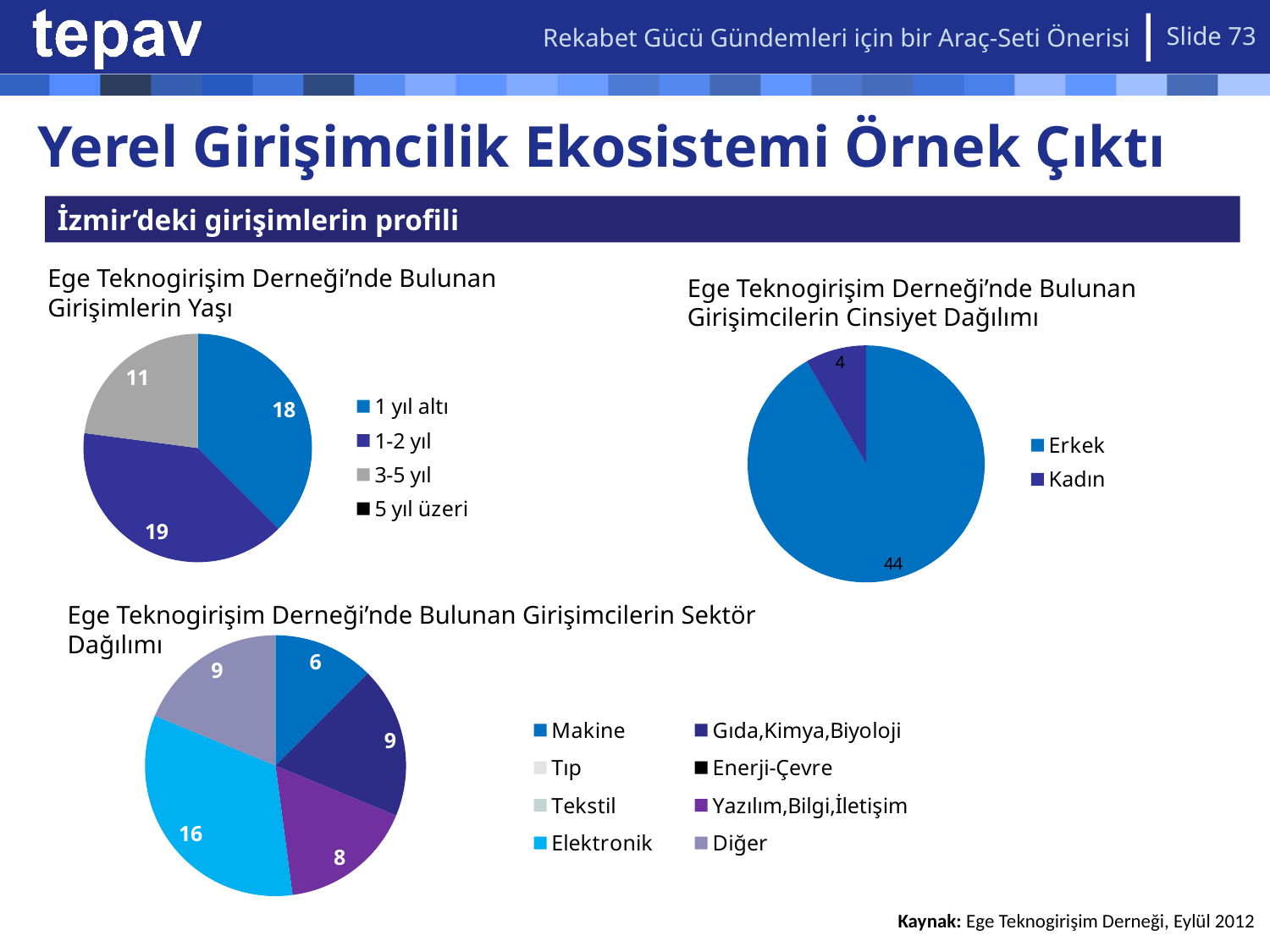
In the chart 'Ege Teknogirişim Derneği'nde Bulunan Girişimcilerin Cinsiyet Dağılımı', what is the total of the two slices? 48 In the chart 'Ege Teknogirişim Derneği'nde Bulunan Girişimcilerin Cinsiyet Dağılımı', what is the value for 'Kadın'? 4 In the chart 'Ege Teknogirişim Derneği'nde Bulunan Girişimcilerin Sektör Dağılımı', which sector has the largest slice? Elektronik In the chart 'Ege Teknogirişim Derneği'nde Bulunan Girişimcilerin Cinsiyet Dağılımı', what is the value for 'Erkek'? 44 In the chart 'Ege Teknogirişim Derneği'nde Bulunan Girişimcilerin Sektör Dağılımı', what is the value for 'Elektronik'? 16 What type of chart is used for 'Ege Teknogirişim Derneği'nde Bulunan Girişimcilerin Cinsiyet Dağılımı'? Pie chart In the chart 'Ege Teknogirişim Derneği'nde Bulunan Girişimlerin Yaşı', which category has the largest slice? 1-2 yıl In the chart 'Ege Teknogirişim Derneği'nde Bulunan Girişimlerin Yaşı', what is the value for '1-2 yıl'? 19 In the chart 'Ege Teknogirişim Derneği'nde Bulunan Girişimlerin Yaşı', what is the difference between the values for '1-2 yıl' and '3-5 yıl'? 8 In the chart 'Ege Teknogirişim Derneği'nde Bulunan Girişimcilerin Sektör Dağılımı', which is larger: 'Makine' or 'Yazılım,Bilgi,İletişim'? Yazılım,Bilgi,İletişim How many entries does the legend of the chart 'Ege Teknogirişim Derneği'nde Bulunan Girişimcilerin Sektör Dağılımı' list? 8 How many entries does the legend of the chart 'Ege Teknogirişim Derneği'nde Bulunan Girişimlerin Yaşı' list? 4